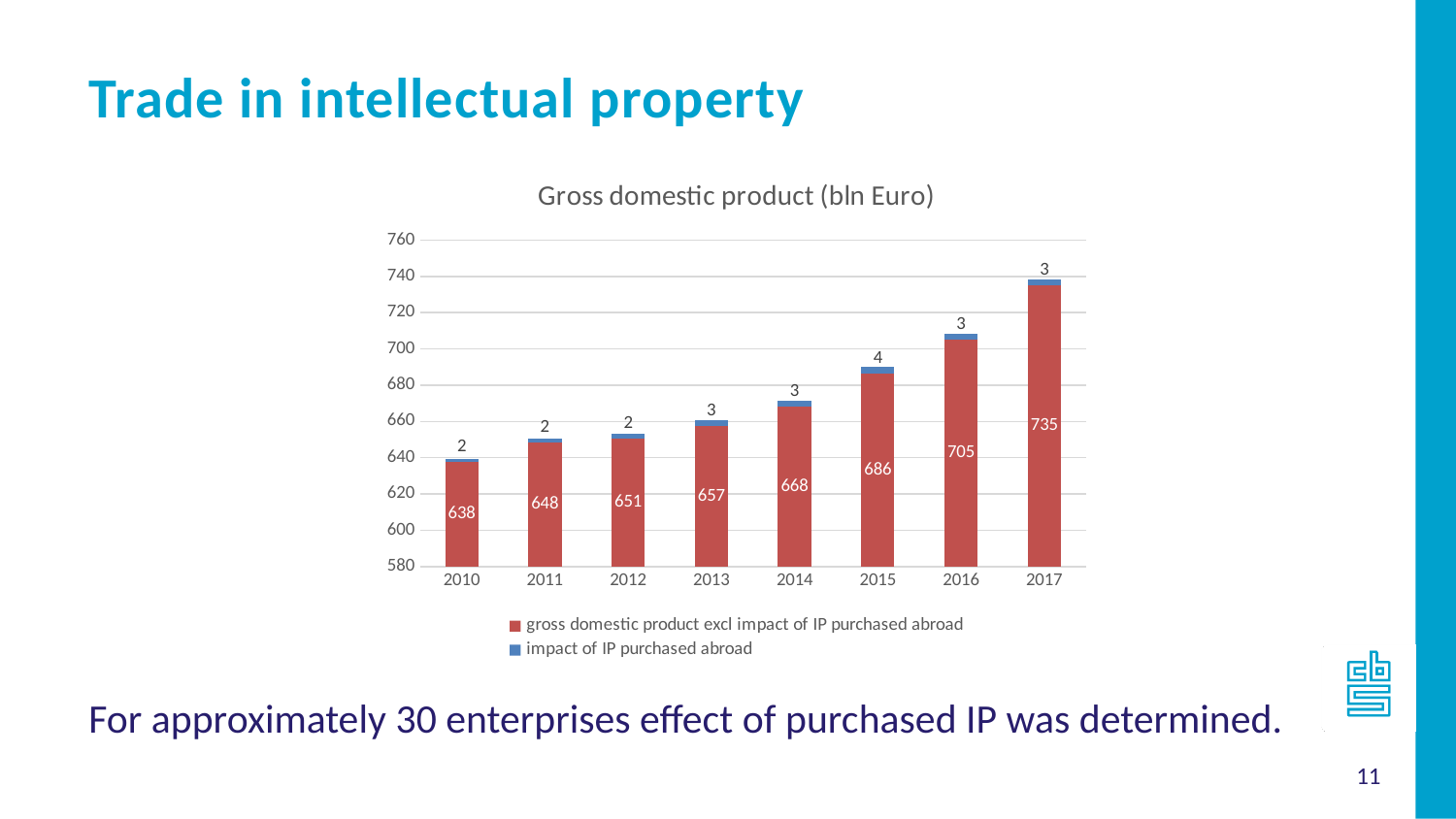
What type of chart is shown on the slide? stacked bar chart What is the value of impact of IP purchased abroad in 2015? 4 What is the difference between the gross domestic product excl impact of IP purchased abroad in 2017 and in 2010? 97 Which year has the lowest value for gross domestic product excl impact of IP purchased abroad? 2010 What is the value of gross domestic product excl impact of IP purchased abroad in 2014? 668 What is the total of the stacked bar for 2016? 708 Is the gross domestic product excl impact of IP purchased abroad in 2016 larger or smaller than in 2015? larger What is the title of the chart? Gross domestic product (bln Euro) Which year has the highest value for gross domestic product excl impact of IP purchased abroad? 2017 How many series does the legend list? 2 Do the values for gross domestic product excl impact of IP purchased abroad rise or fall from 2010 to 2017? rise How many years are shown on the x axis? 8